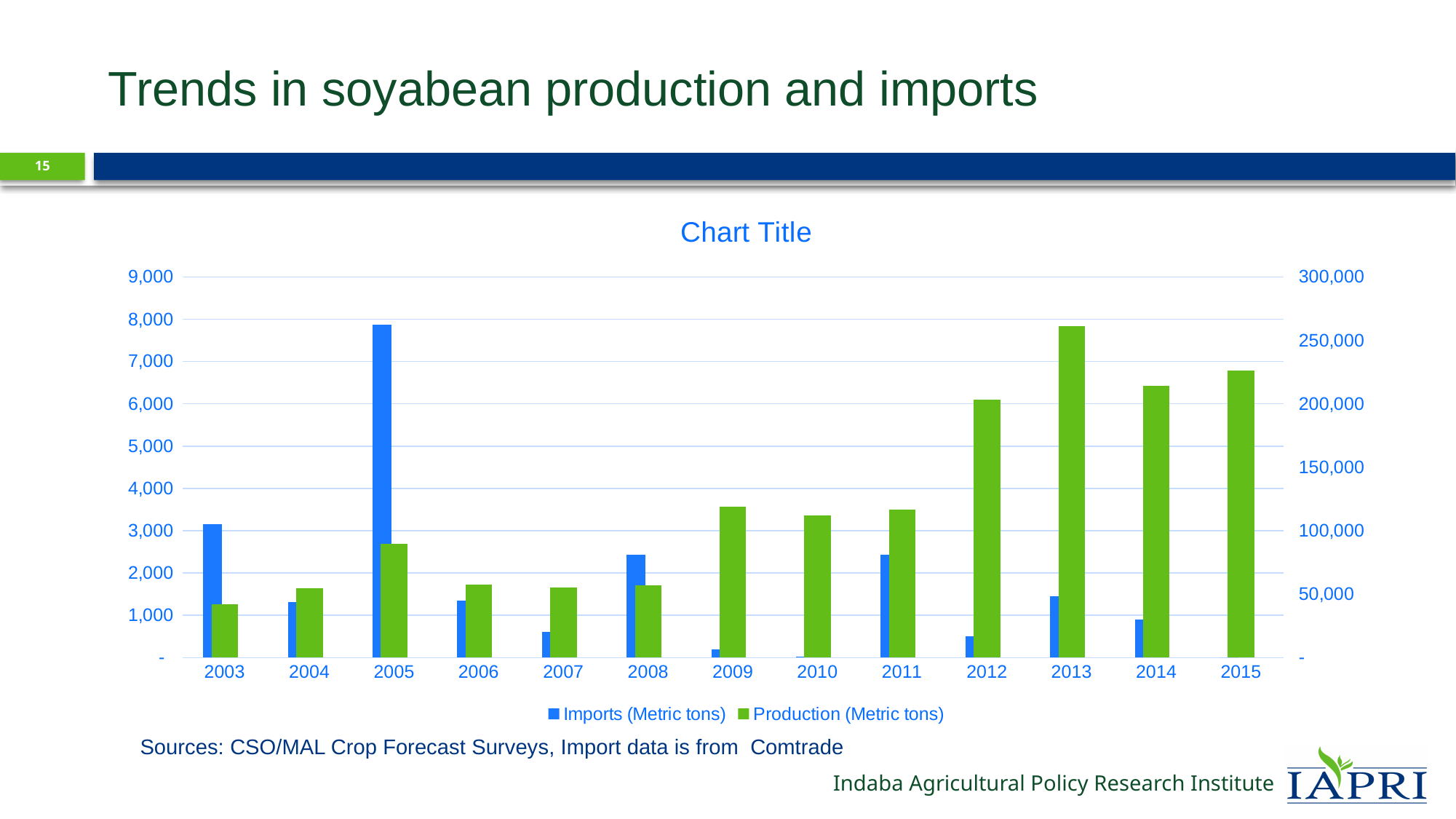
How many years are shown on the x axis? 13 How many series does the legend list? 2 Is the value for Production (Metric tons) in 2009 greater or less than 100,000? greater Which year has the lowest value for Production (Metric tons)? 2003 Which year has the larger value for Production (Metric tons), 2013 or 2015? 2013 Which year has the highest value for Production (Metric tons)? 2013 Is the value for Production (Metric tons) in 2013 greater or less than 250,000? greater Is the value for Imports (Metric tons) in 2005 greater or less than 7,000? greater What kind of chart is shown on the slide? Bar chart Which year has the larger value for Imports (Metric tons), 2003 or 2008? 2003 Which year has the highest value for Imports (Metric tons)? 2005